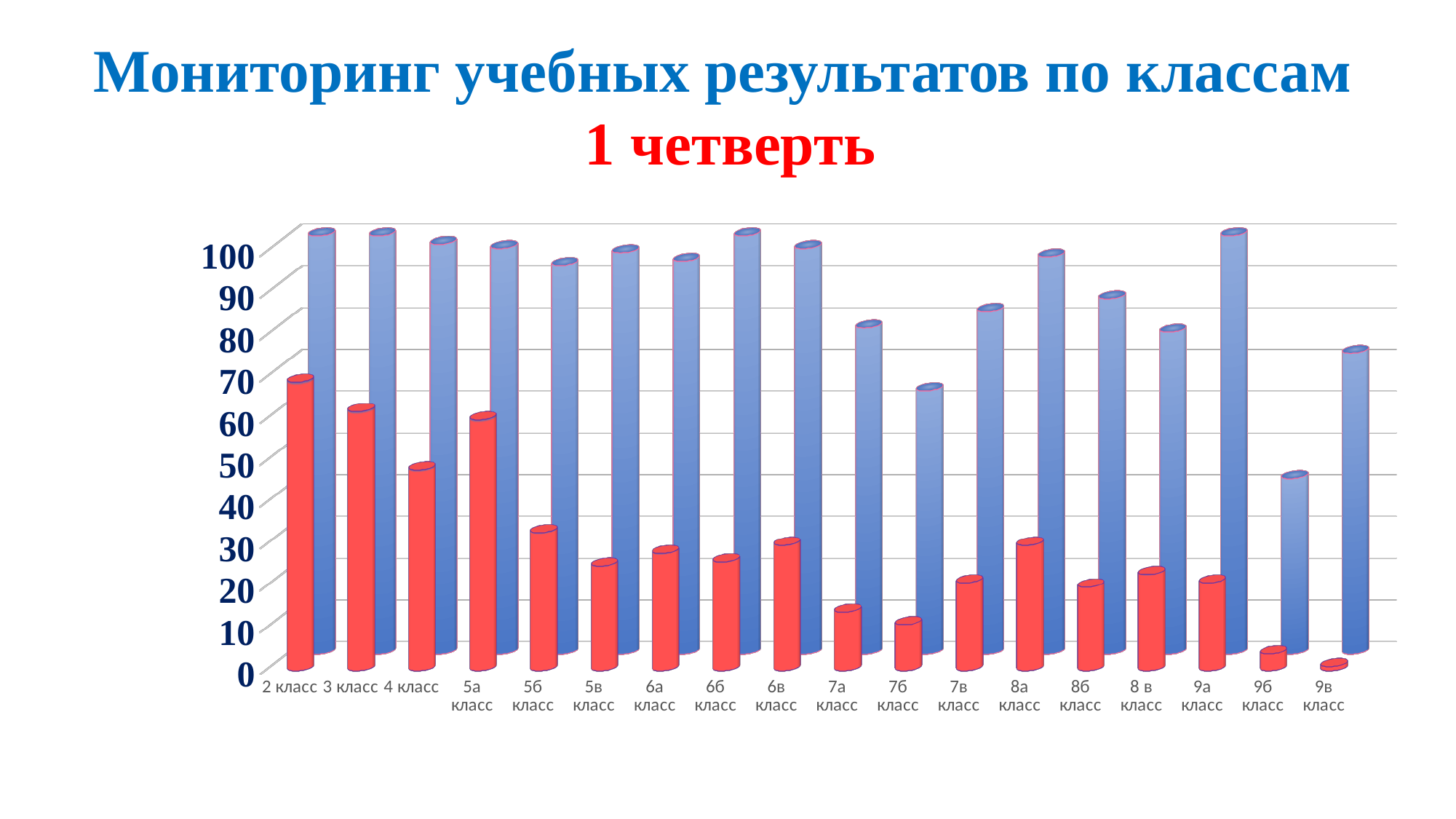
Is the red bar for 9б класс greater or less than 10? less What two colours are used for the bars in the chart? red and blue Which class has the lowest red bar? 9в класс How many class categories are shown on the x axis? 18 What kind of chart is shown on the slide? bar chart Is the red bar for 2 класс greater or less than 60? greater Which class has the lowest blue bar? 9б класс Which class has the highest red bar? 2 класс Which is larger: the blue bar for 9б класс or the blue bar for 9в класс? 9в класс Is the blue bar for 9б класс greater or less than 50? less What is the title of the slide? Мониторинг учебных результатов по классам 1 четверть